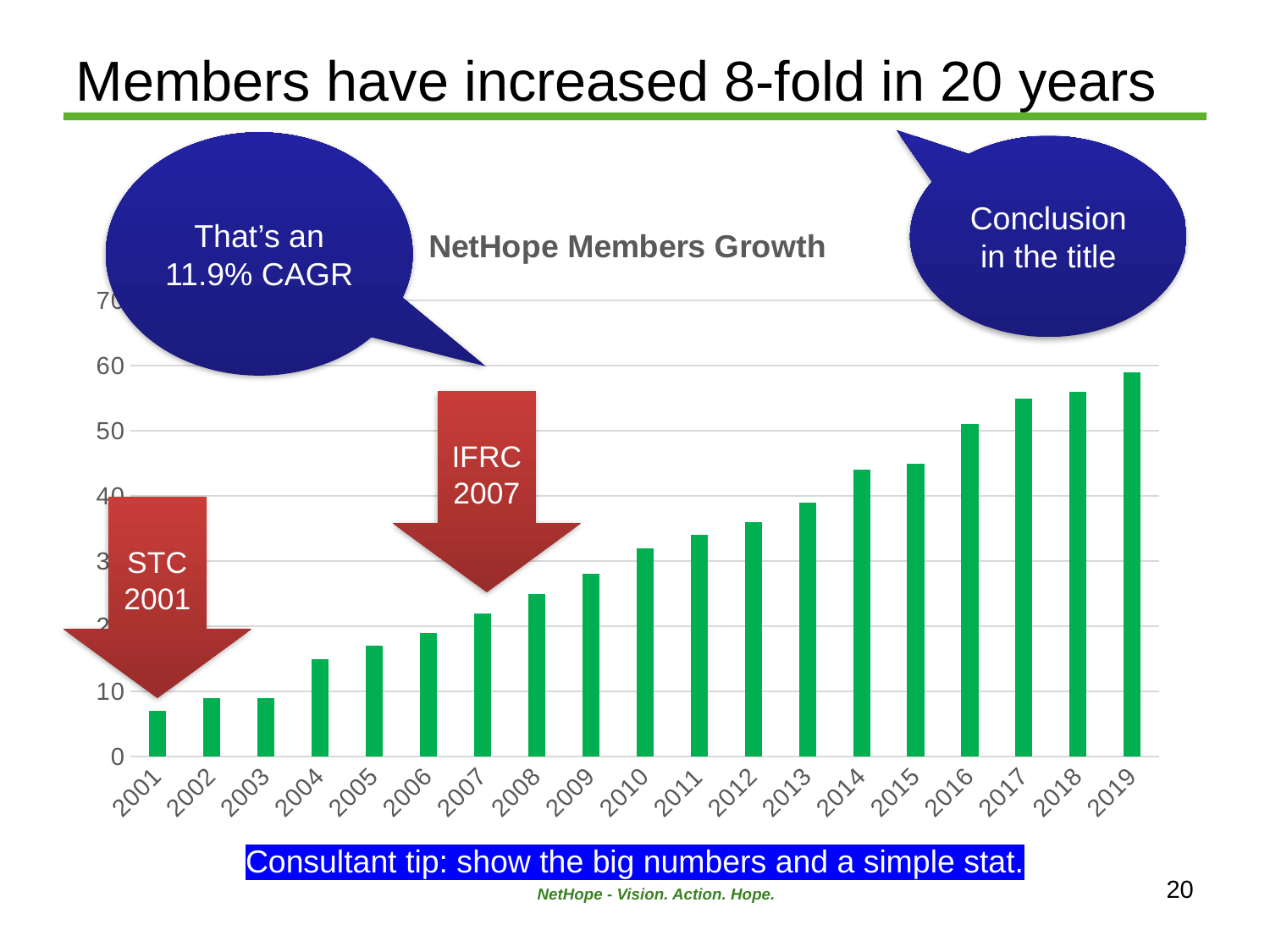
Is the value for 2001 greater or less than 10? less Is the value for 2019 greater or less than 50? greater Is the value for 2008 greater or less than 30? less Do the values generally rise or fall from 2001 to 2019? rise How many years are plotted on the x axis of the chart? 19 What colour are the bars in the chart? green What is the title of the chart? NetHope Members Growth Which year has the highest bar in the chart? 2019 What kind of chart is shown on the slide? bar chart Which year has the larger value, 2005 or 2015? 2015 Which year has the lowest bar in the chart? 2001